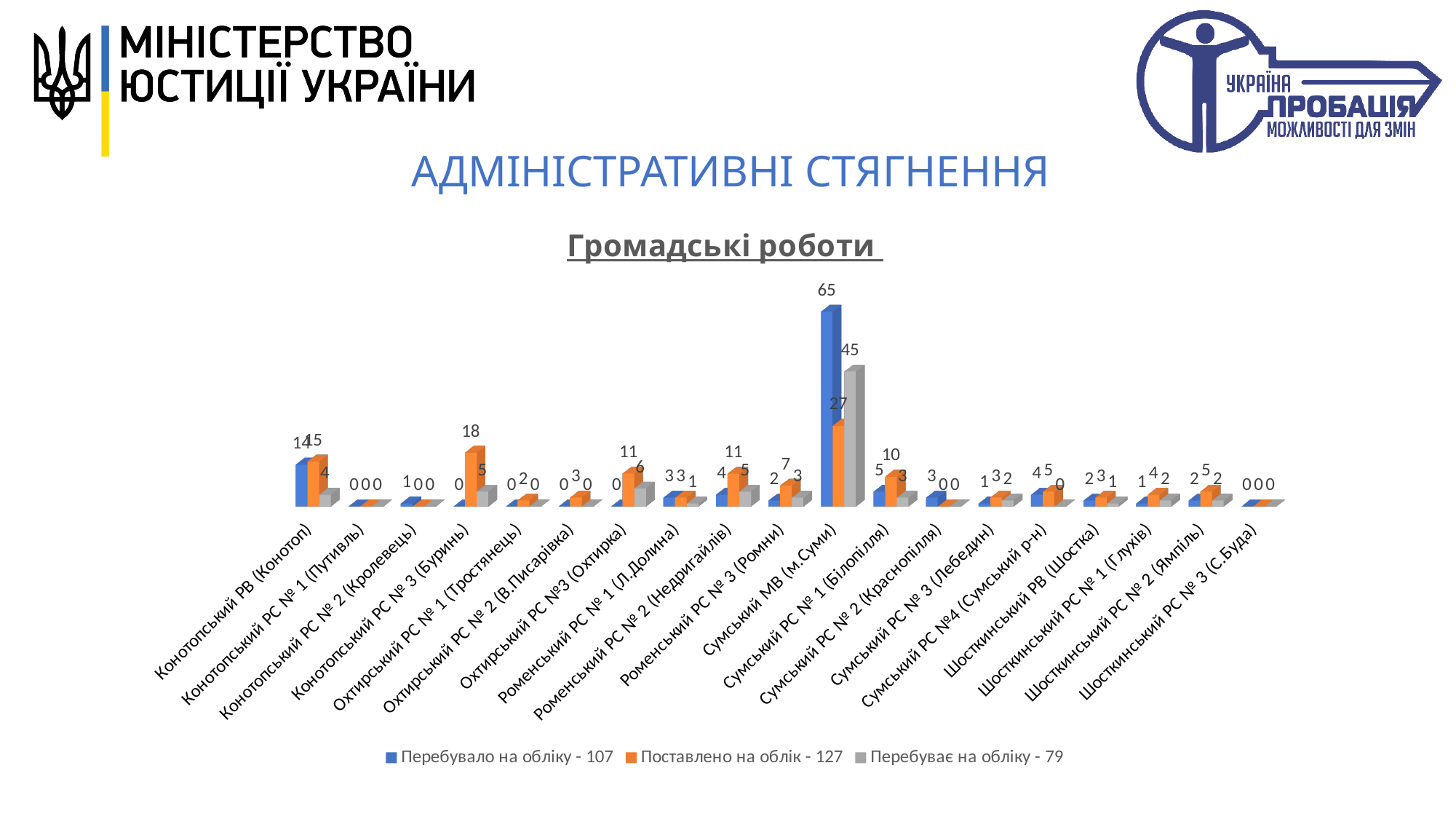
Which category has the highest value for 'Поставлено на облік'? Сумський МВ (м.Суми) What type of chart is shown on the slide? bar chart Which is larger for Роменський РС № 2 (Недригайлів): 'Поставлено на облік' or 'Перебувало на обліку'? Поставлено на облік What is the value of 'Перебувало на обліку' for Сумський МВ (м.Суми)? 65 How many series does the legend list? 3 What is the value of 'Перебуває на обліку' for Охтирський РС №3 (Охтирка)? 6 What is the title of the chart? Громадські роботи What is the value of 'Поставлено на облік' for Конотопський РС № 3 (Буринь)? 18 What total is shown in the legend entry for 'Перебуває на обліку'? 79 How many categories are shown on the x axis of the chart? 19 What is the total of the three series for Конотопський РВ (Конотоп)? 33 What is the difference between 'Перебувало на обліку' and 'Перебуває на обліку' for Сумський МВ (м.Суми)? 20